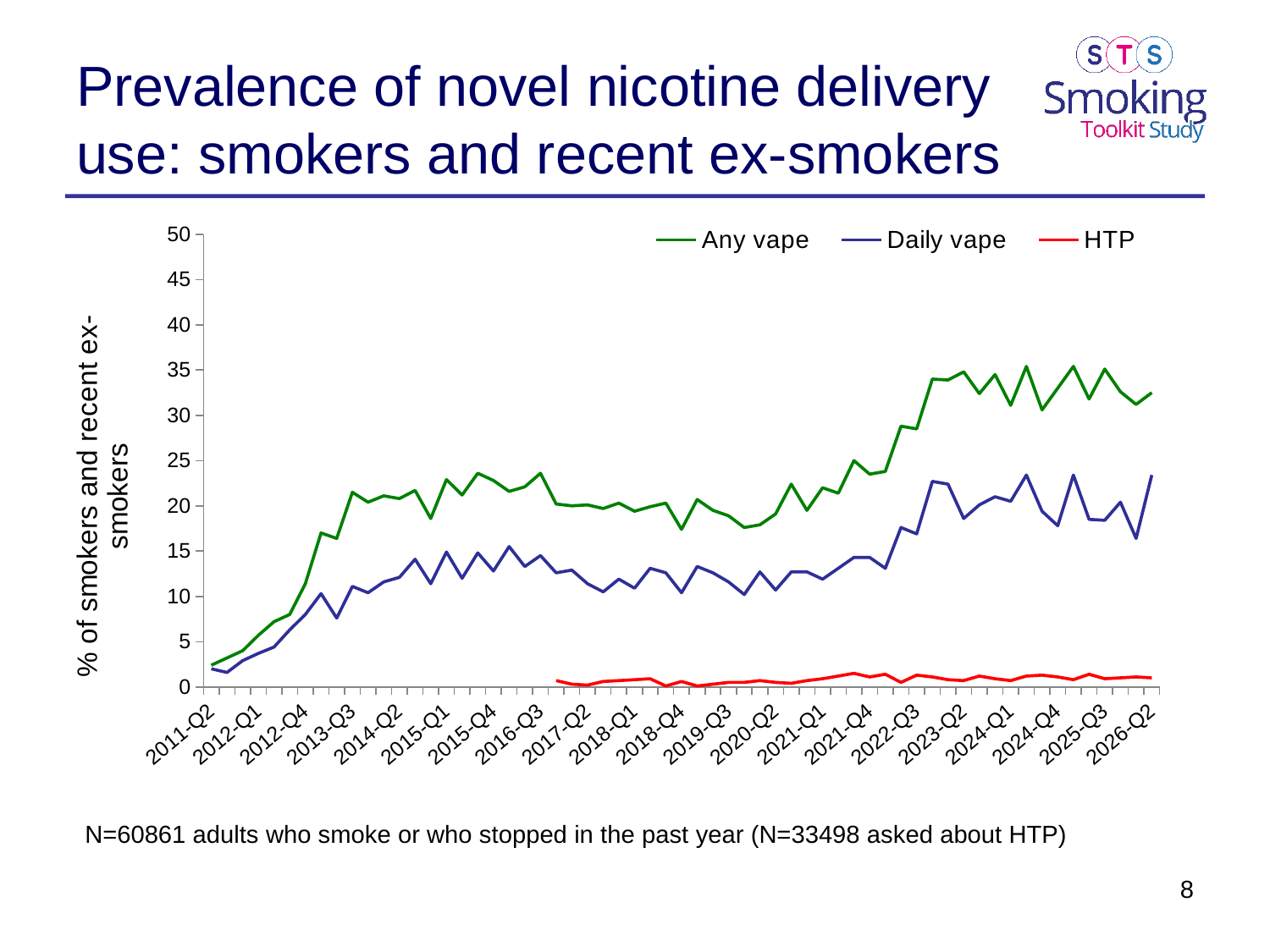
Is the value for HTP at 2017-Q2 greater or less than 5? less Does the Any vape line rise or fall between 2011-Q2 and 2013-Q3? Rises How many series does the legend list? 3 Is the value for Daily vape at 2026-Q2 greater or less than 20? greater Is the value for Any vape at 2011-Q2 greater or less than 5? less Which series is drawn in red? HTP Which series has the lowest values across the chart? HTP How many x-axis labels are shown on the chart? 21 Which series has the highest values across the chart? Any vape At 2026-Q2, which is larger: Any vape or Daily vape? Any vape What kind of chart is shown on the slide? Line chart